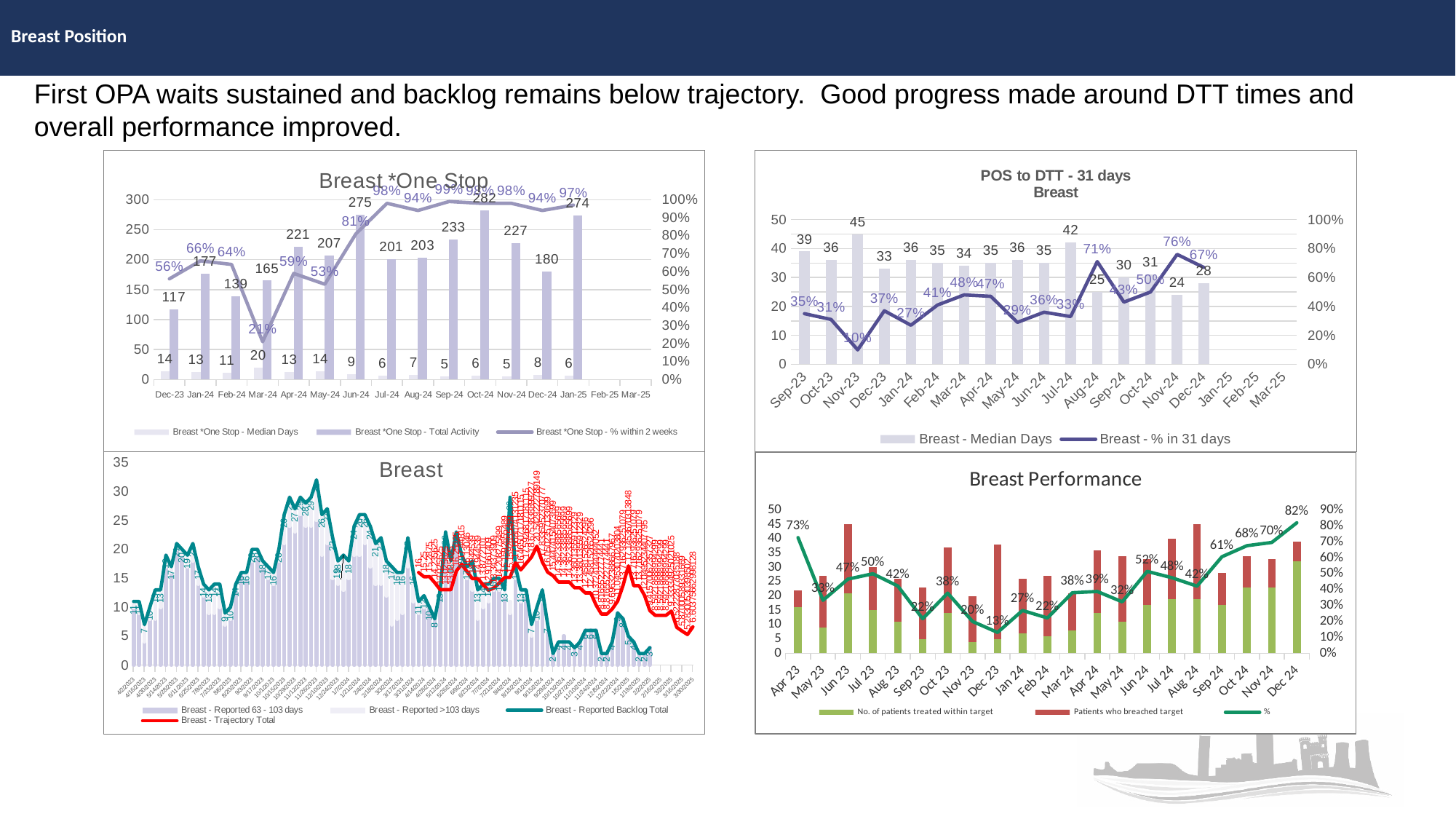
In the 'POS to DTT - 31 days Breast' chart, is the Median Days value larger for Jul-24 or Aug-24? Jul-24 In the 'Breast Performance' chart, which month has the lowest % value? Dec 23 In the 'Breast *One Stop' chart, what is the '% within 2 weeks' value for Mar-24? 21% In the 'Breast *One Stop' chart, how many series does the legend list? 3 In the 'Breast Performance' chart, what is the % value for Dec 24? 82% In the 'POS to DTT - 31 days Breast' chart, what is the Median Days value for Nov-23? 45 In the 'POS to DTT - 31 days Breast' chart, what is the '% in 31 days' value for Nov-24? 76% In the 'Breast *One Stop' chart, which month has the highest Total Activity? Oct-24 In the 'POS to DTT - 31 days Breast' chart, which month has the lowest '% in 31 days' value? Nov-23 In the 'Breast *One Stop' chart, what is the difference in Total Activity between Jun-24 and Dec-24? 95 In the 'Breast Performance' chart, what is the difference between the % values for Dec 24 and Apr 23? 9% In the 'Breast *One Stop' chart, what is the Total Activity value for Oct-24? 282